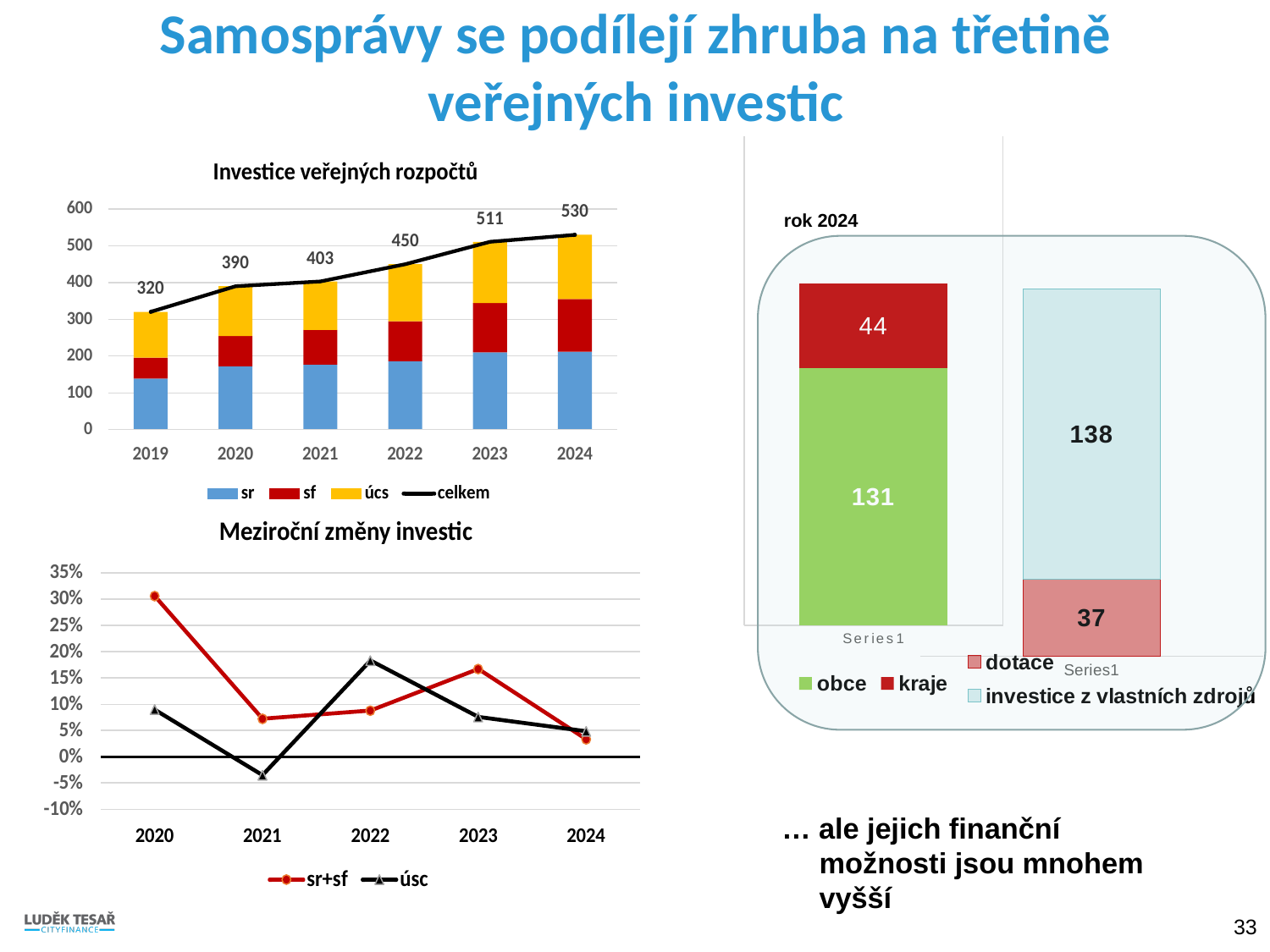
In the chart 'Investice veřejných rozpočtů', does the 'celkem' line rise or fall from 2019 to 2024? rise How many years are shown on the x axis of the chart 'Meziroční změny investic'? 5 In the chart 'Investice veřejných rozpočtů', what is the value of 'celkem' for 2024? 530 In the chart 'Investice veřejných rozpočtů', which year has the highest 'celkem' value? 2024 In the chart 'Investice veřejných rozpočtů', what is the value of 'celkem' for 2019? 320 In the chart 'Meziroční změny investic', is the value for 'úsc' in 2022 greater or less than 15%? greater In the 'rok 2024' chart on the right with 'obce' and 'kraje', what is the value for 'obce'? 131 In the 'rok 2024' chart on the right with 'obce' and 'kraje', what is the total of the stacked bar? 175 How many series does the legend of the chart 'Investice veřejných rozpočtů' list? 4 In the chart on the right with 'dotace' and 'investice z vlastních zdrojů', which segment is larger? investice z vlastních zdrojů In the chart 'Investice veřejných rozpočtů', by how much did 'celkem' increase from 2019 to 2024? 210 In the chart 'Meziroční změny investic', is the value for 'úsc' in 2021 greater or less than 0%? less